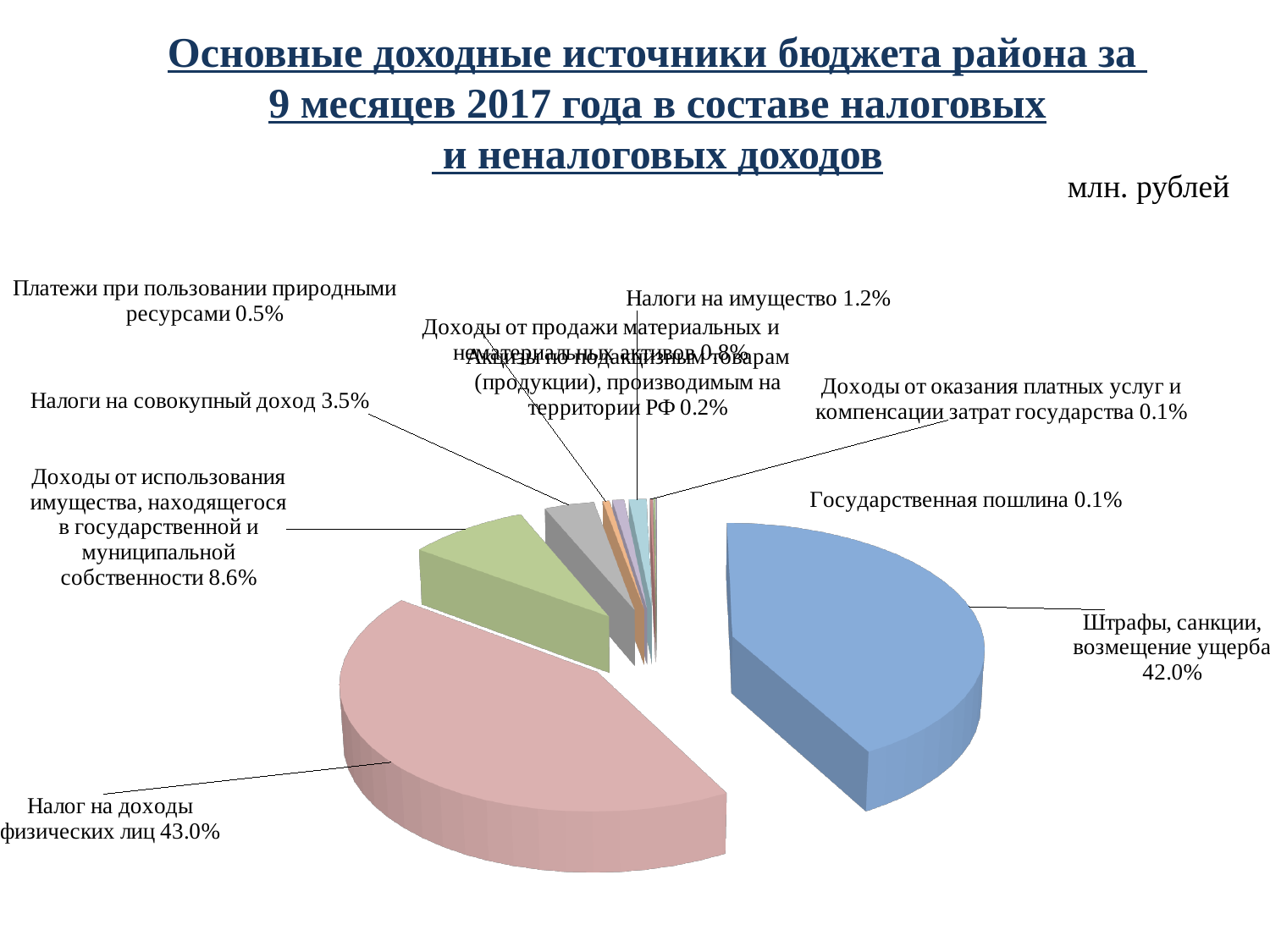
What kind of chart is shown on the slide? pie chart What share of the pie is labelled for Налог на доходы физических лиц? 43.0% What percentage is shown for Доходы от использования имущества, находящегося в государственной и муниципальной собственности? 8.6% What percentage is shown for Налоги на имущество? 1.2% Which category has the largest share of the pie? Налог на доходы физических лиц Which is larger: the share for Налоги на совокупный доход or the share for Налоги на имущество? Налоги на совокупный доход What share is shown for Штрафы, санкции, возмещение ущерба? 42.0% What is the difference in percentage points between Налог на доходы физических лиц and Штрафы, санкции, возмещение ущерба? 1.0 What unit is stated above the chart? млн. рублей What percentage is shown for Налоги на совокупный доход? 3.5% What percentage is shown for Платежи при пользовании природными ресурсами? 0.5% What percentage is shown for Государственная пошлина? 0.1%